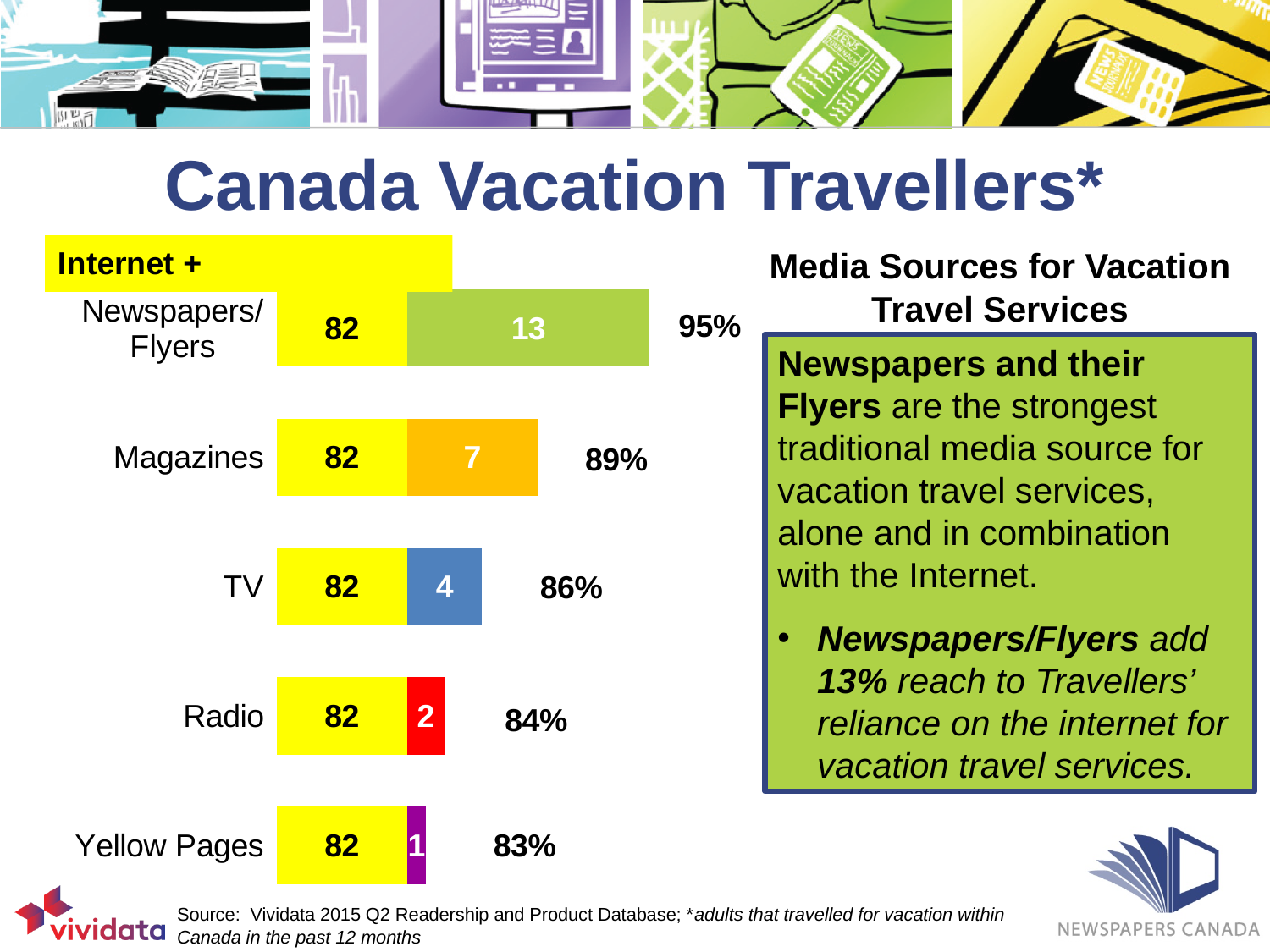
What kind of chart is shown on the slide? Stacked bar chart Which media category adds the most reach to the Internet? Newspapers/Flyers What is the Internet value shown in each bar? 82 Which media category adds the least reach to the Internet? Yellow Pages What is the combined reach shown for Internet + Magazines? 89% What is the added reach value for TV? 4 What is the total of the stacked bar for Yellow Pages? 83% What is the added reach value for Newspapers/Flyers beyond the Internet? 13 Which has a higher combined reach, Magazines or TV? Magazines How many media categories are shown in the chart? 5 What is the title of the chart on the right side of the slide? Media Sources for Vacation Travel Services What is the difference between the combined reach for Newspapers/Flyers and for Radio? 11%